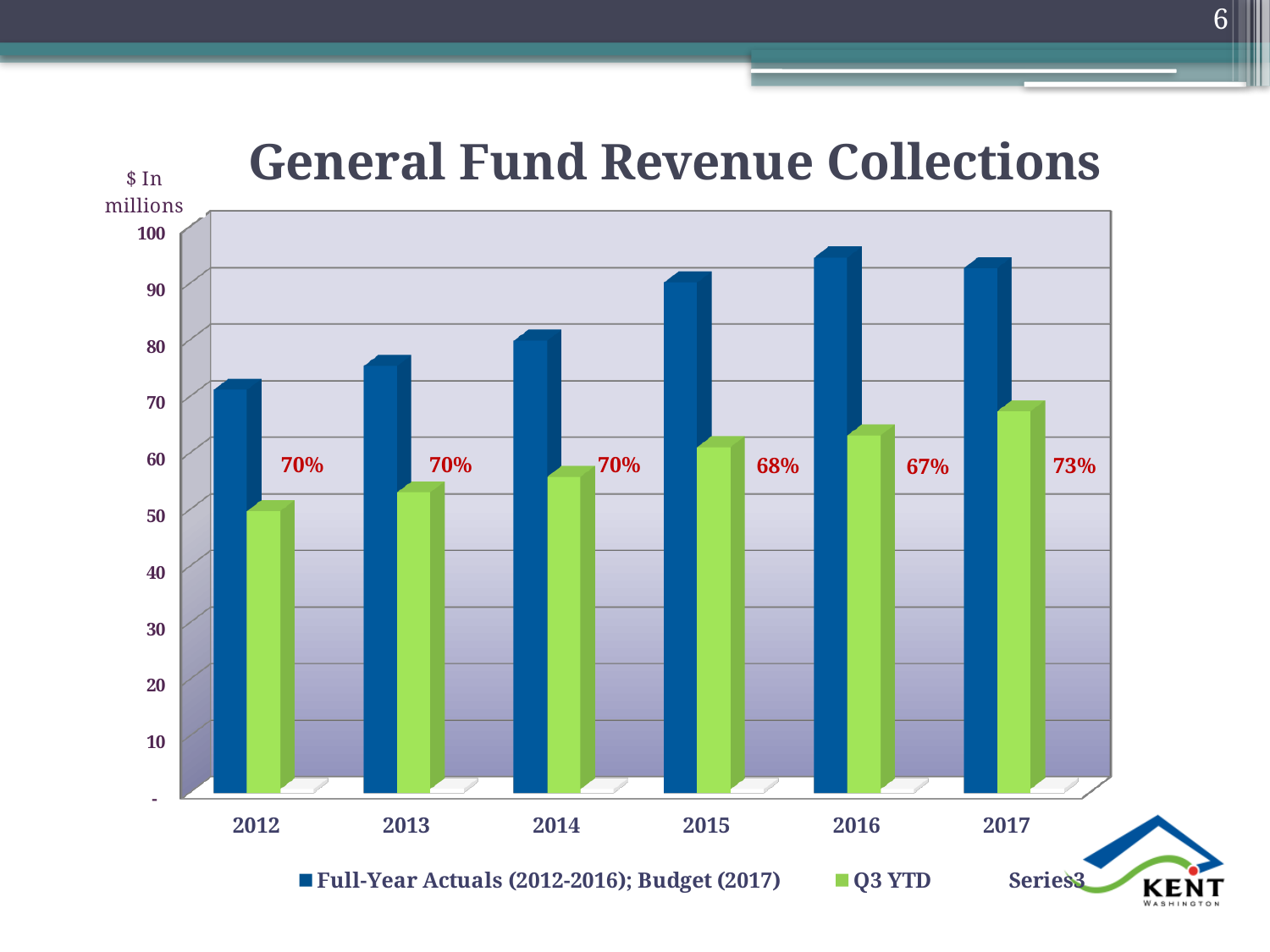
What percentage label is shown for 2016? 67% Is the Q3 YTD value for 2014 greater or less than 60? less Which year has the highest percentage label? 2017 Which year has the lowest percentage label? 2016 Is the Full-Year Actuals value for 2016 greater or less than 90? greater What percentage label is shown for 2017? 73% What type of chart is shown on the slide? Bar chart How many years are shown on the x axis of the chart? 6 How many series does the chart legend list? 3 Which year has the tallest Full-Year Actuals (2012-2016); Budget (2017) bar? 2016 Which year has the shortest Q3 YTD bar? 2012 What percentage label is shown for 2015? 68%